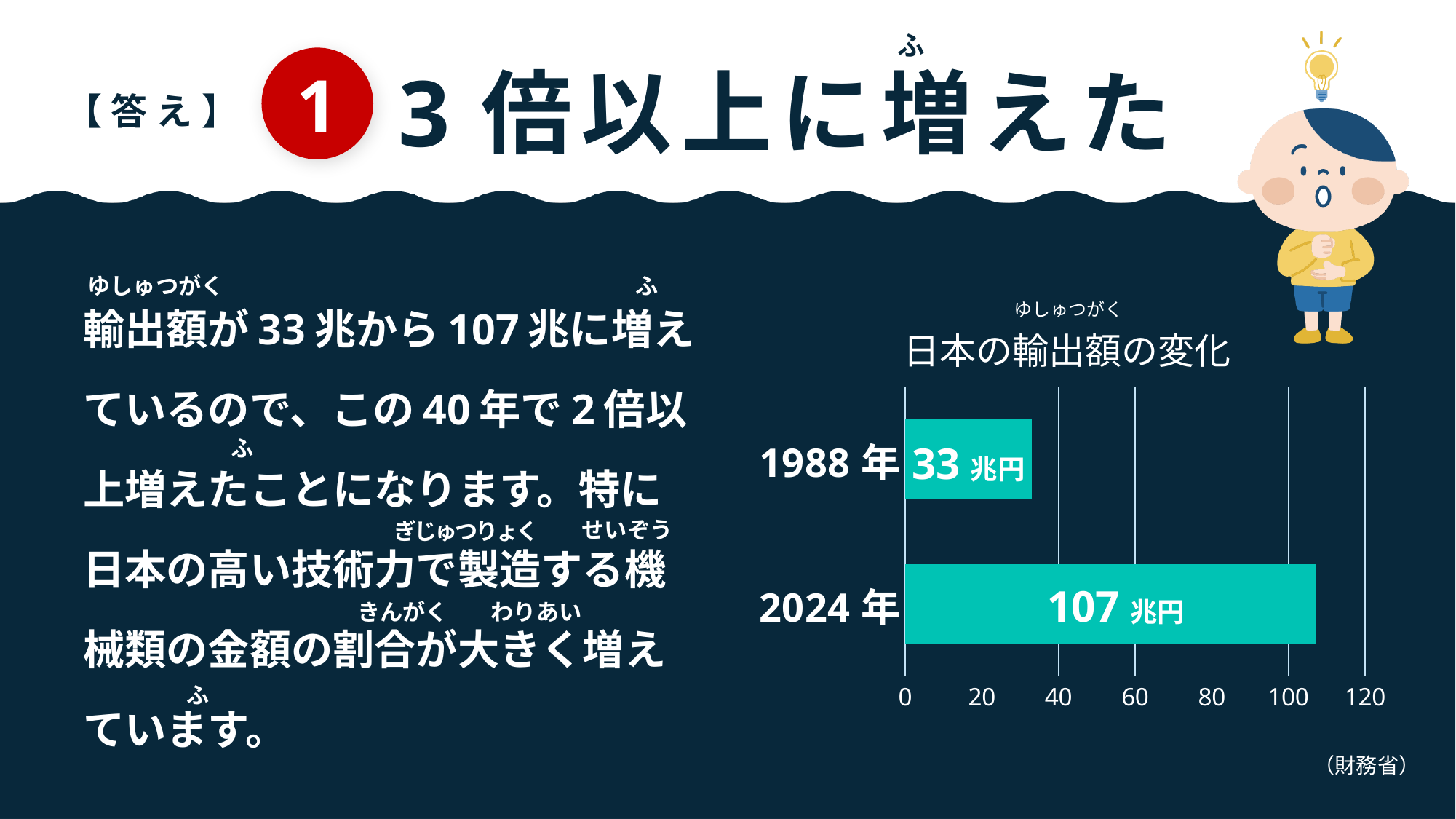
What is the value for 2024年 in the chart 日本の輸出額の変化? 107 兆円 What is the title of the chart on the slide? 日本の輸出額の変化 What is the maximum value shown on the chart's axis? 120 What kind of chart is shown on the slide? bar chart Is the value for 2024年 larger or smaller than the value for 1988年? larger What is the difference between the 2024年 and 1988年 values in the chart? 74 兆円 Which year has the lower export value in the chart? 1988年 Is the value for 1988年 greater or less than 40? less Which year has the higher export value in the chart? 2024年 What is the value for 1988年 in the chart 日本の輸出額の変化? 33 兆円 Is the value for 2024年 greater or less than 100? greater How many categories (years) are shown in the chart? 2